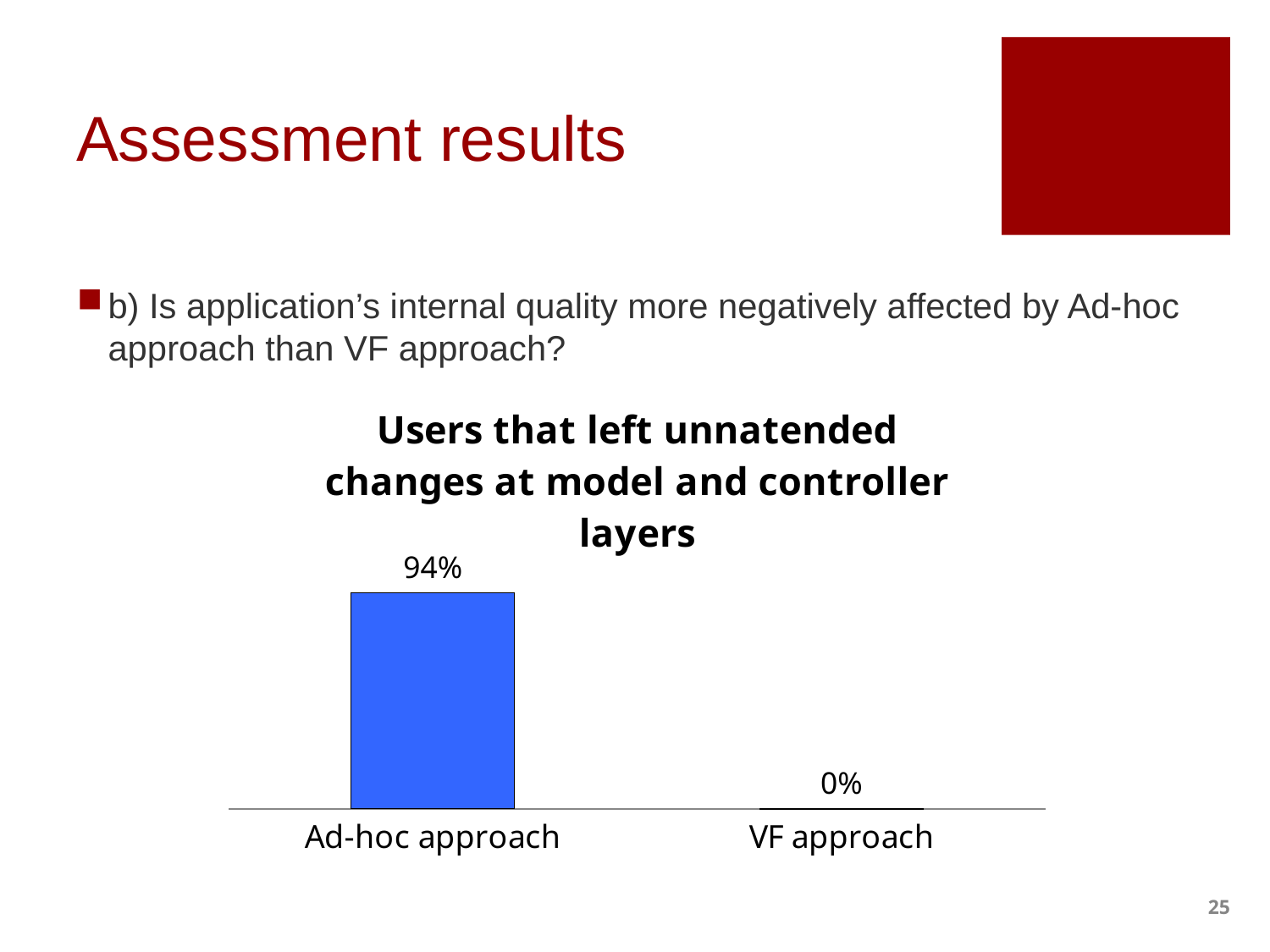
What kind of chart is shown on the slide? Bar chart What is the value for VF approach? 0% What is the value for Ad-hoc approach? 94% How many categories are shown in the chart? 2 Do the values rise or fall from Ad-hoc approach to VF approach? Fall What is the difference between the values for Ad-hoc approach and VF approach? 94% What is the title of the chart? Users that left unnatended changes at model and controller layers Which category has the highest value? Ad-hoc approach Which category has the lowest value? VF approach Which is larger, the value for Ad-hoc approach or the value for VF approach? Ad-hoc approach What colour is the bar for Ad-hoc approach? Blue